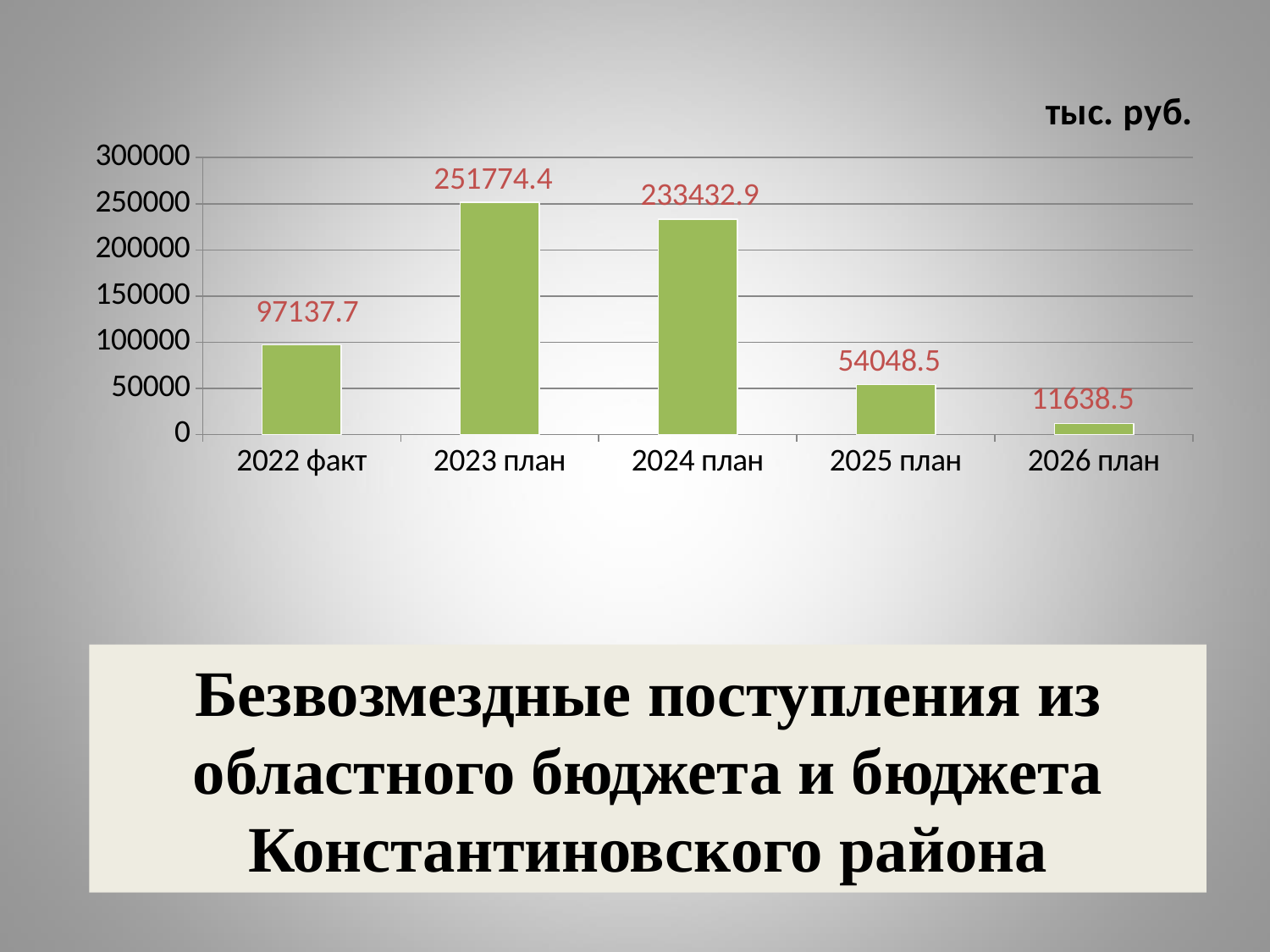
What kind of chart is shown on the slide? bar chart How many categories are shown on the x axis? 5 What is the value for 2022 факт? 97137.7 Is the value for 2024 план greater or less than 200000? greater What is the difference between the values for 2022 факт and 2025 план? 43089.2 What unit of measurement is indicated above the chart? тыс. руб. What is the value for 2023 план? 251774.4 Which is larger, the value for 2022 факт or the value for 2025 план? 2022 факт Which category has the highest value? 2023 план What is the difference between the values for 2023 план and 2024 план? 18341.5 What is the value for 2026 план? 11638.5 Which category has the lowest value? 2026 план